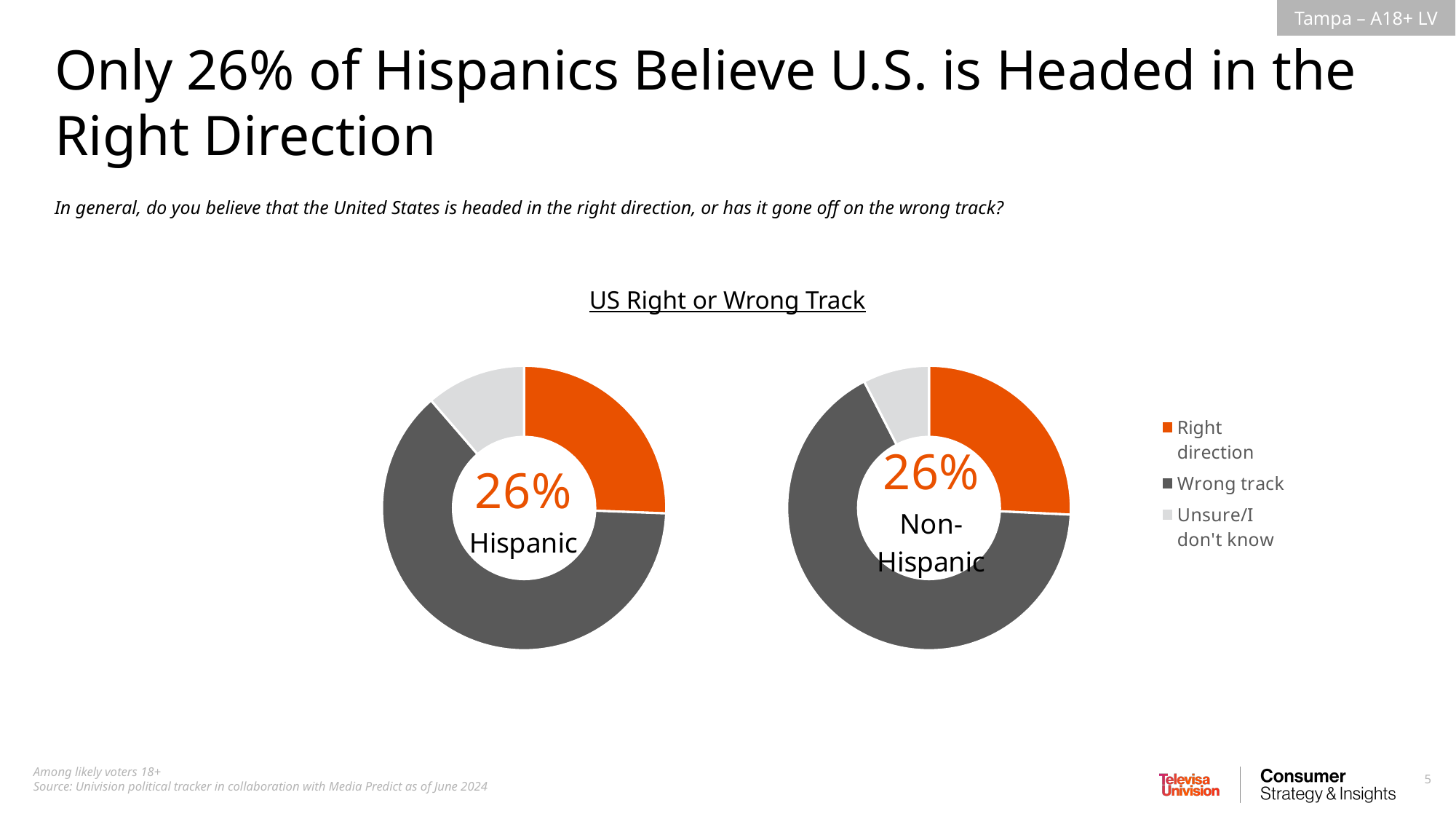
In the Non-Hispanic donut chart, what share chose Right direction? 26% How many response categories does the legend list for the US Right or Wrong Track charts? 3 In the Hispanic donut chart, which response has the smallest slice? Unsure/I don't know In the Hispanic donut chart, which response has the largest slice? Wrong track In the Non-Hispanic donut chart, which slice is larger: Wrong track or Right direction? Wrong track In the Non-Hispanic donut chart, which response has the largest slice? Wrong track In the Hispanic donut chart, what share chose Right direction? 26% How many donut charts are shown under the US Right or Wrong Track title? 2 What kind of chart is used to show the US Right or Wrong Track results? Pie (donut) chart Is the Right direction share for Hispanic larger than, smaller than, or the same as for Non-Hispanic? the same What colour represents Right direction in the donut charts? Orange In the Non-Hispanic donut chart, which response has the smallest slice? Unsure/I don't know